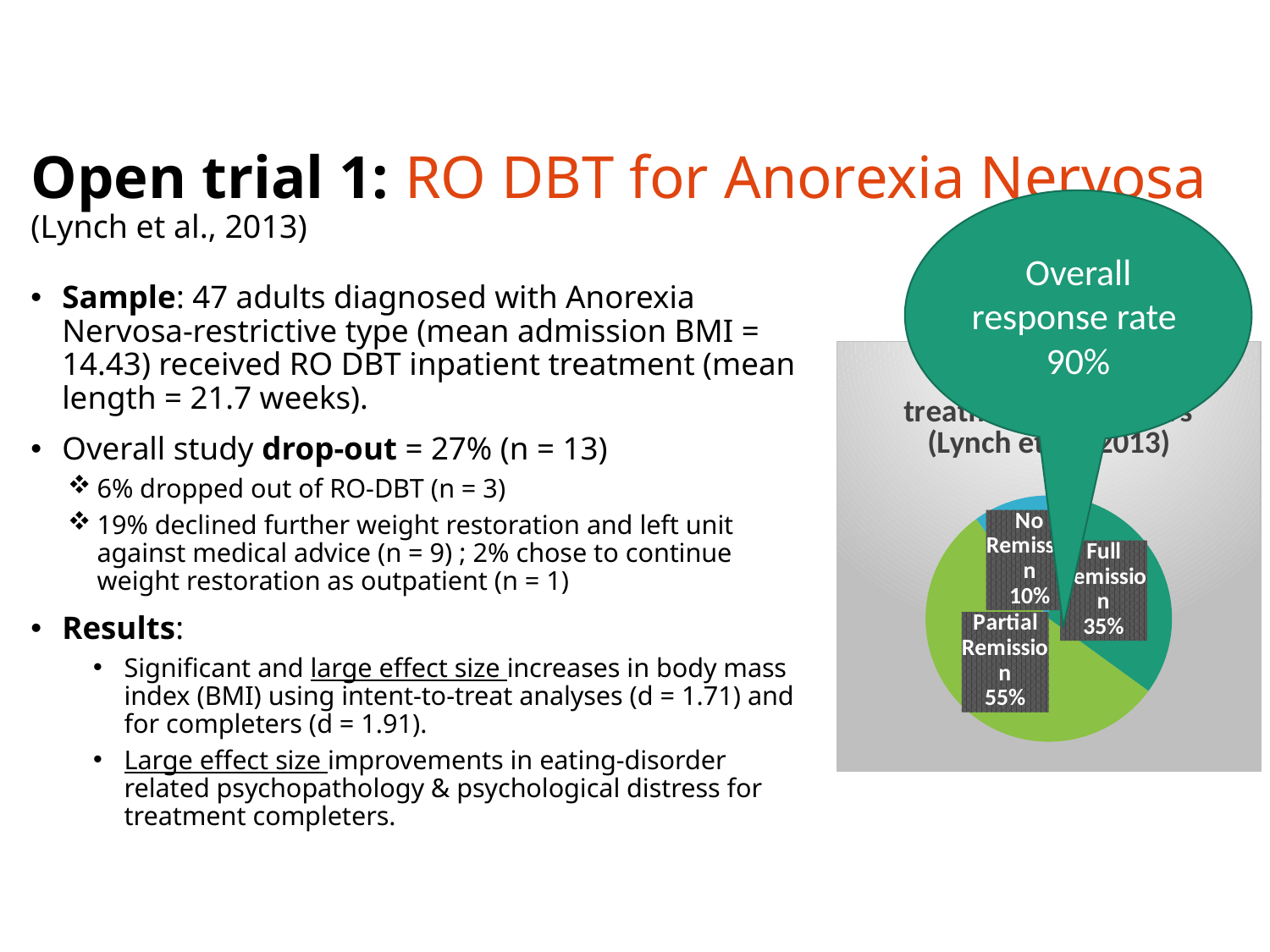
In the pie chart, what is the difference in percentage points between Full Remission and No Remission? 25 In the pie chart, what percentage is shown for No Remission? 10% In the pie chart, what percentage is shown for Full Remission? 35% Which slice of the pie chart is the smallest? No Remission What colour is the Partial Remission slice of the pie chart? green Which slice of the pie chart is the largest? Partial Remission In the pie chart, which is larger: Full Remission or No Remission? Full Remission In the pie chart, what percentage is shown for Partial Remission? 55% What overall response rate is stated in the callout over the pie chart? 90% How many slices does the pie chart have? 3 What kind of chart is shown on the right side of the slide? pie chart In the pie chart, what is the difference in percentage points between Partial Remission and Full Remission? 20